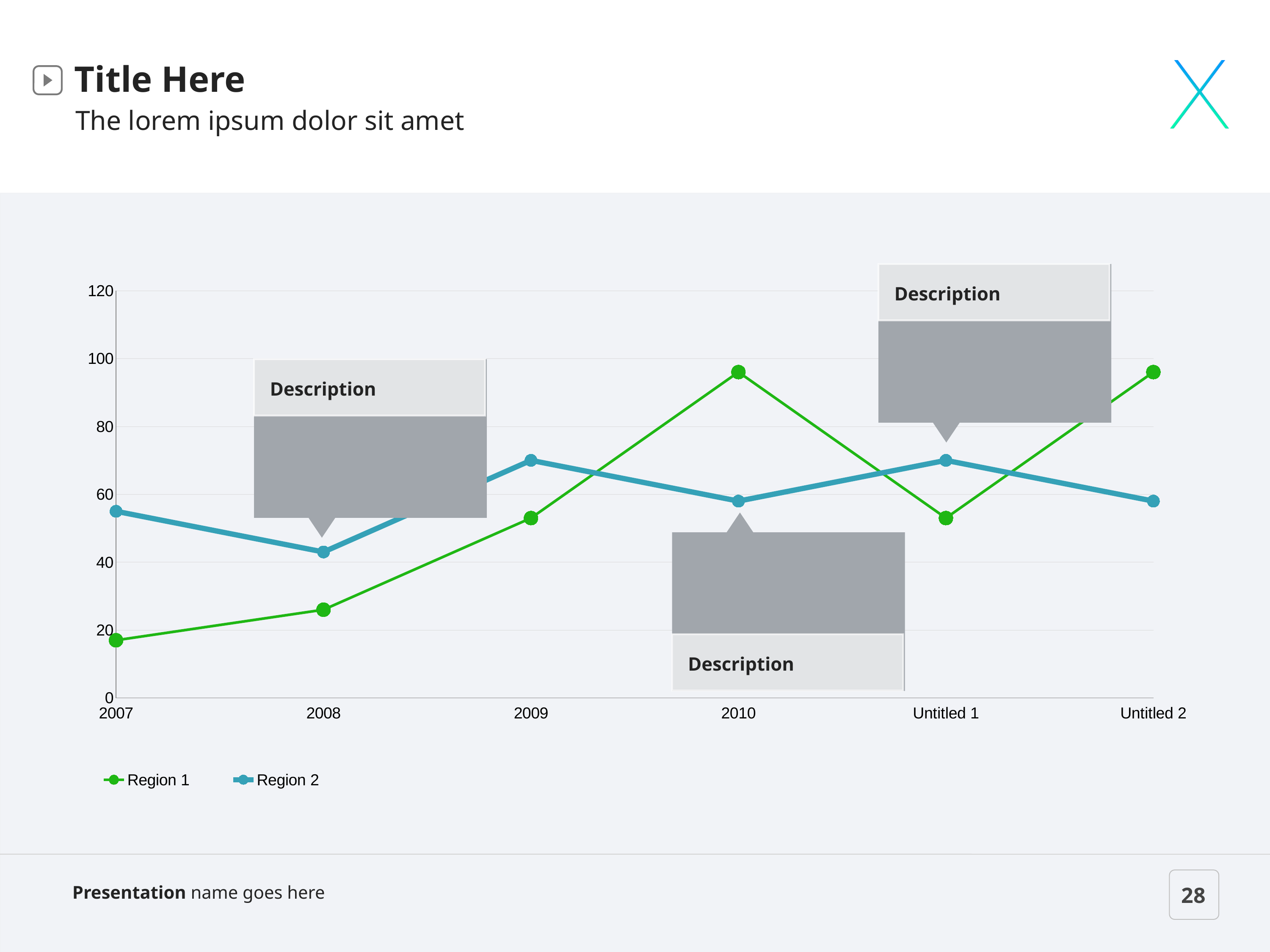
Is the value for Region 1 in 2010 greater or less than 80? greater Does the Region 1 line rise or fall from 2007 to 2010? rise How many categories are shown on the x axis? 6 In 2010, which series has the larger value, Region 1 or Region 2? Region 1 Is the value for Region 1 in 2007 greater or less than 20? less Is the value for Region 1 in 2009 greater or less than 60? less What kind of chart is shown on the slide? line chart In 2007, which series has the larger value, Region 1 or Region 2? Region 2 Which category has the lowest value for Region 2? 2008 Which category has the lowest value for Region 1? 2007 How many series does the legend list? 2